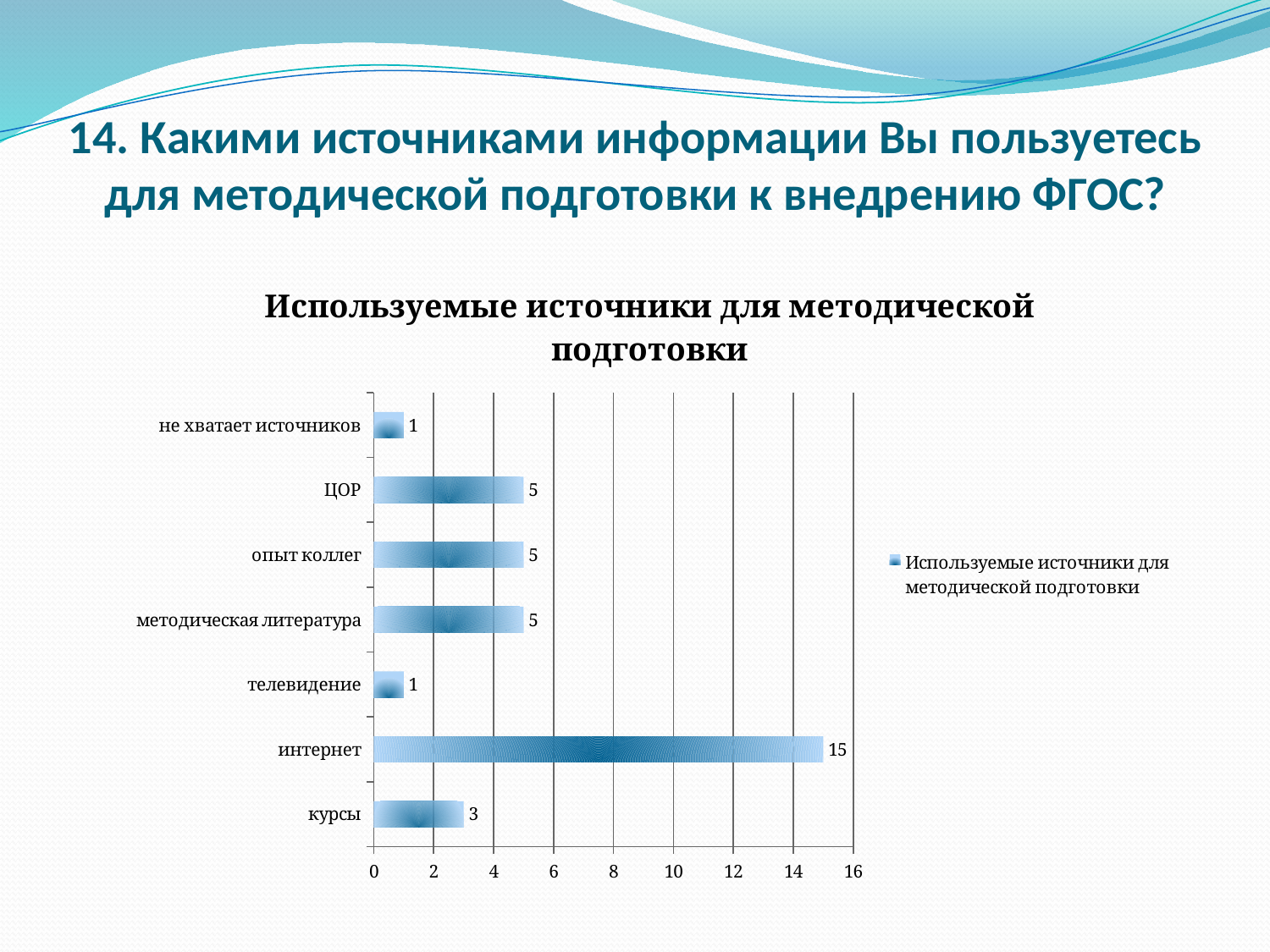
Which is larger, the value for опыт коллег or the value for курсы? опыт коллег Is the value for интернет greater or less than 10? greater What is the difference between the values for интернет and курсы? 12 What is the title of the chart? Используемые источники для методической подготовки How many series does the legend list? 1 What kind of chart is shown on the slide? bar chart What is the value for интернет? 15 How many categories are shown in the chart? 7 What is the value for ЦОР? 5 What is the value for телевидение? 1 Which category has the highest value? интернет What is the value for курсы? 3